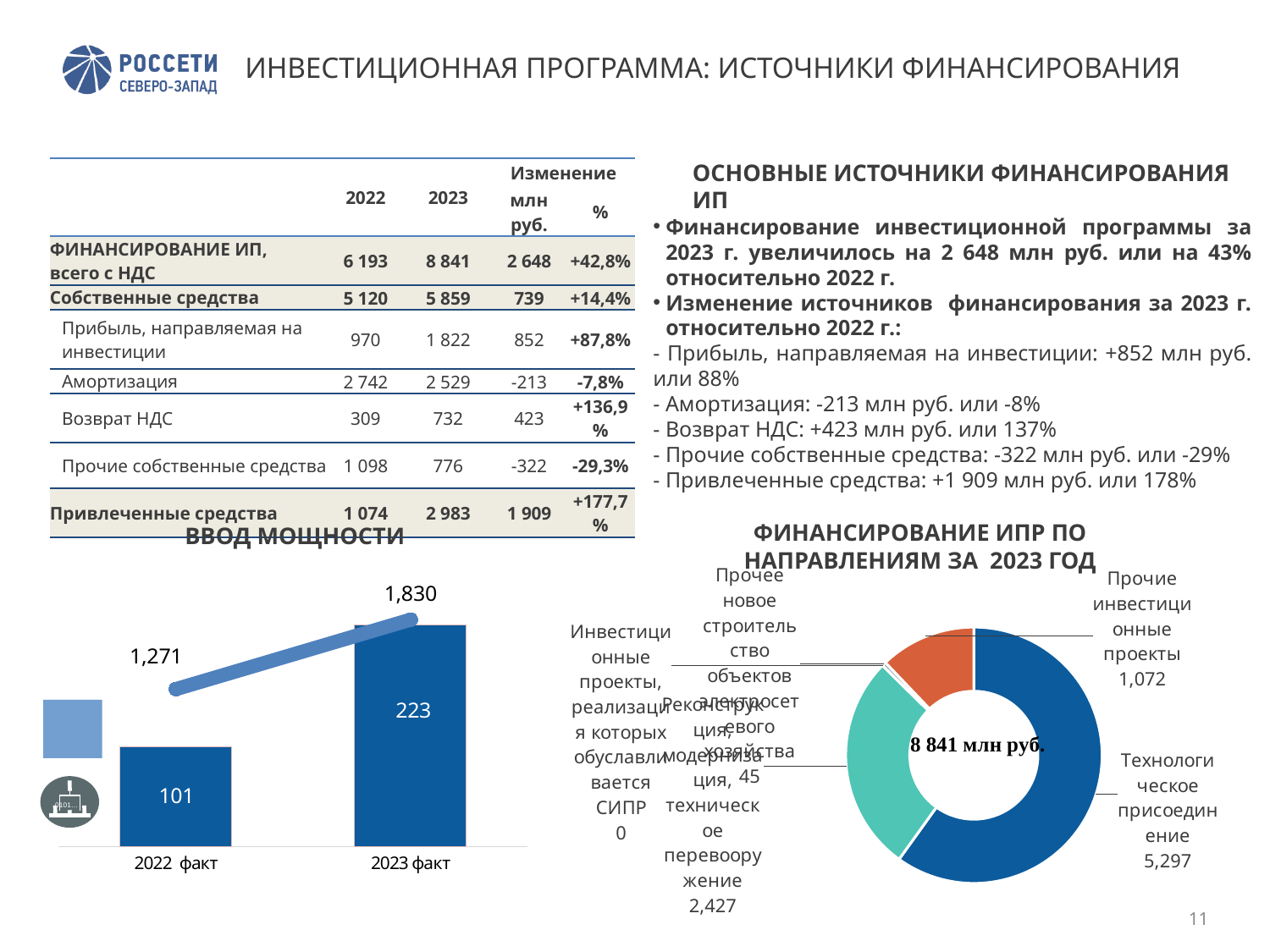
How many categories are shown on the x axis of the 'ВВОД МОЩНОСТИ' chart? 2 In the 'ВВОД МОЩНОСТИ' chart, do the bar values rise or fall from 2022 факт to 2023 факт? rise In the 'ВВОД МОЩНОСТИ' chart, what is the difference between the bar values for 2023 факт and 2022 факт? 122 What kind of chart is the 'ВВОД МОЩНОСТИ' chart on the bottom left? combination bar and line chart In the 'ФИНАНСИРОВАНИЕ ИПР ПО НАПРАВЛЕНИЯМ ЗА 2023 ГОД' chart, which is larger: Прочие инвестиционные проекты or Реконструкция, модернизация, техническое перевооружение? Реконструкция, модернизация, техническое перевооружение In the 'ВВОД МОЩНОСТИ' chart, what is the upper value labelled above 2023 факт? 1,830 In the 'ФИНАНСИРОВАНИЕ ИПР ПО НАПРАВЛЕНИЯМ ЗА 2023 ГОД' chart, what total is printed in the centre of the doughnut? 8 841 млн руб. In the 'ФИНАНСИРОВАНИЕ ИПР ПО НАПРАВЛЕНИЯМ ЗА 2023 ГОД' chart, which category has the largest value? Технологическое присоединение In the 'ВВОД МОЩНОСТИ' chart, what is the value of the bar for 2022 факт? 101 In the 'ФИНАНСИРОВАНИЕ ИПР ПО НАПРАВЛЕНИЯМ ЗА 2023 ГОД' chart, what is the value for Технологическое присоединение? 5,297 In the 'ВВОД МОЩНОСТИ' chart, what is the value of the bar for 2023 факт? 223 What kind of chart is 'ФИНАНСИРОВАНИЕ ИПР ПО НАПРАВЛЕНИЯМ ЗА 2023 ГОД'? doughnut (pie) chart